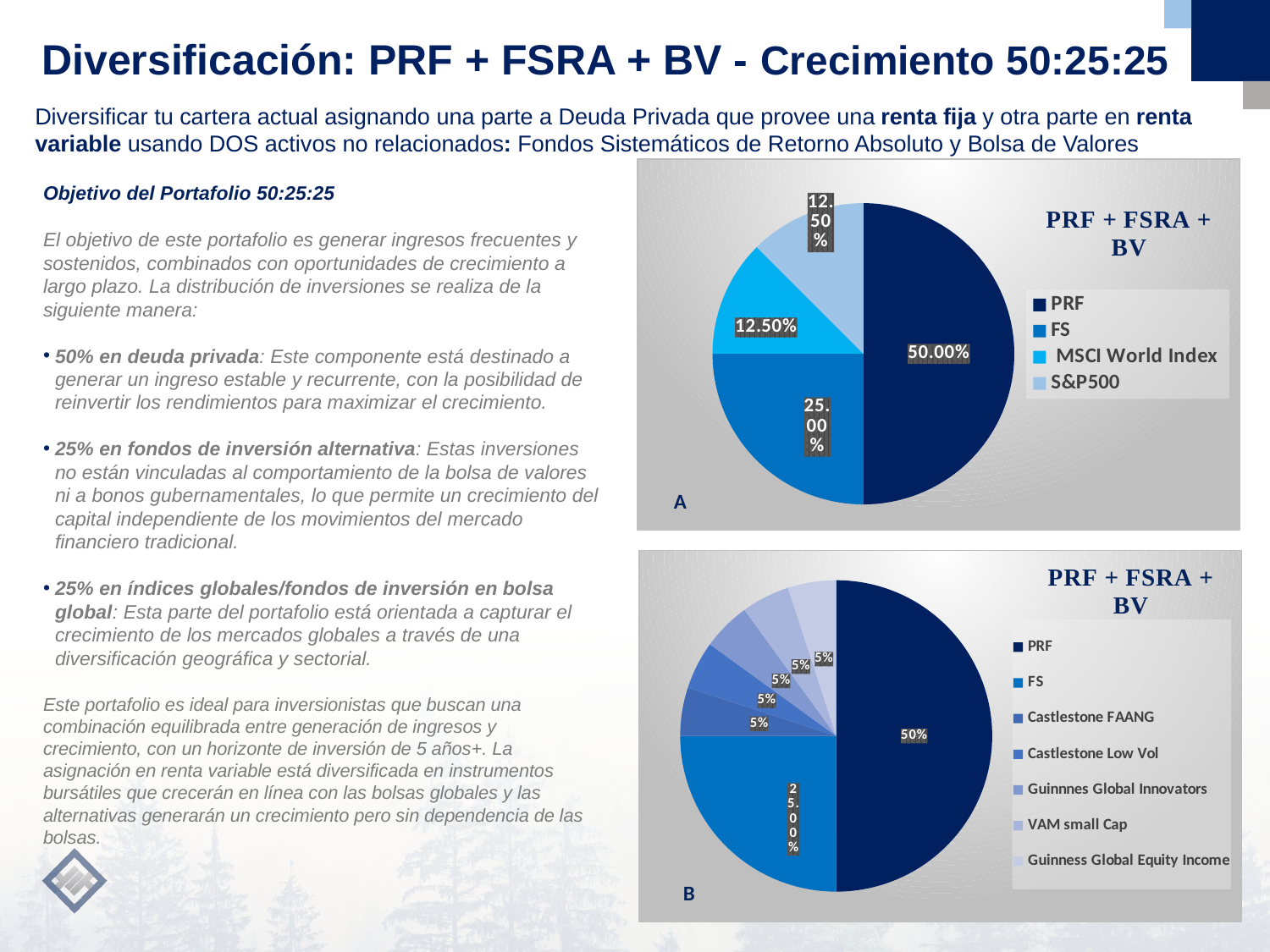
In the top pie chart (A), what share does PRF have? 50.00% What kind of chart is the bottom chart (B)? Pie chart In the top pie chart (A), what share does the MSCI World Index have? 12.50% In the top pie chart (A), what is the difference between the PRF share and the FS share? 25.00% In the bottom pie chart (B), what share does Castlestone FAANG have? 5% In the bottom pie chart (B), how many entries does the legend list? 7 What is the title shown on the top pie chart (A)? PRF + FSRA + BV In the bottom pie chart (B), what share does PRF have? 50% In the top pie chart (A), how many entries does the legend list? 4 In the top pie chart (A), which category has the largest slice? PRF In the bottom pie chart (B), which is larger, the FS slice or the VAM small Cap slice? FS In the top pie chart (A), what share does FS have? 25.00%